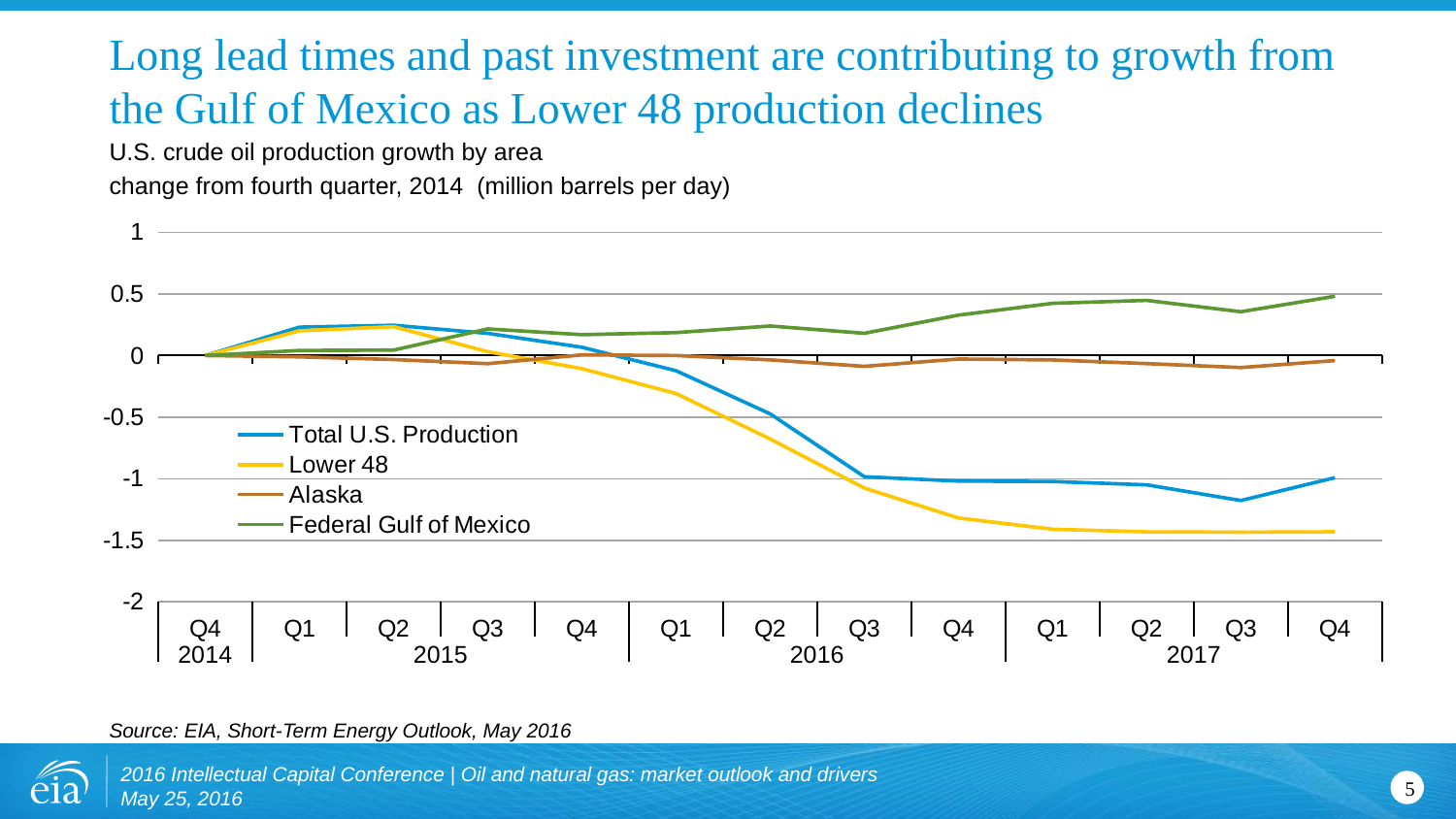
Does the Federal Gulf of Mexico line rise or fall from Q4 2014 to Q4 2017? Rise Is the value for Total U.S. Production in Q3 2017 greater or less than -1? less Does the Lower 48 line rise or fall from Q4 2014 to Q4 2017? Fall In Q4 2017, which is higher: Federal Gulf of Mexico or Lower 48? Federal Gulf of Mexico Which series has the lowest value in Q4 2017? Lower 48 Is the value for Federal Gulf of Mexico in Q4 2017 greater or less than 0? greater How many quarters are plotted along the x axis? 13 How many series does the legend list? 4 Is the value for Lower 48 in Q4 2017 greater or less than -1? less What kind of chart is shown on the slide? Line chart Which series has the highest value in Q4 2017? Federal Gulf of Mexico What unit is the chart measured in, according to the subtitle? million barrels per day